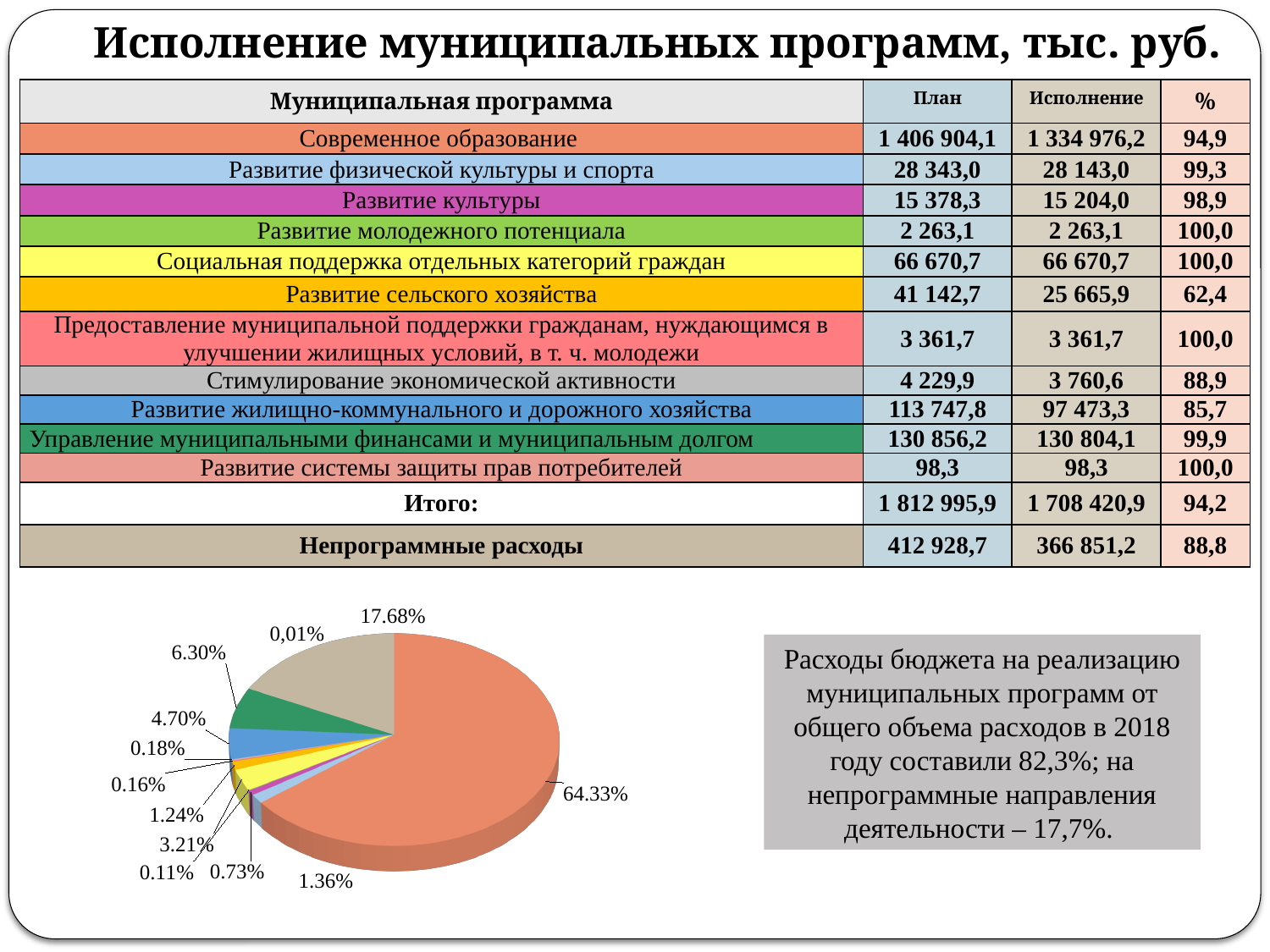
What share does the beige slice at the top of the pie chart represent? 17.68% What share does the blue slice of the pie chart represent? 4.70% Does the pie chart on the slide have a legend? No Which is larger on the pie chart: the slice labelled 6.30% or the slice labelled 4.70%? 6.30% What is the share of the largest slice of the pie chart? 64.33% What is the share of the smallest labelled slice of the pie chart? 0,01% What is the combined share of the two largest slices of the pie chart (64.33% and 17.68%)? 82.01% What share does the green slice of the pie chart represent? 6.30% What kind of chart is shown at the bottom left of the slide? Pie chart What is the difference between the largest slice (64.33%) and the beige slice (17.68%) of the pie chart? 46.65% How many slices are labelled on the pie chart? 12 What share does the large orange slice of the pie chart represent? 64.33%